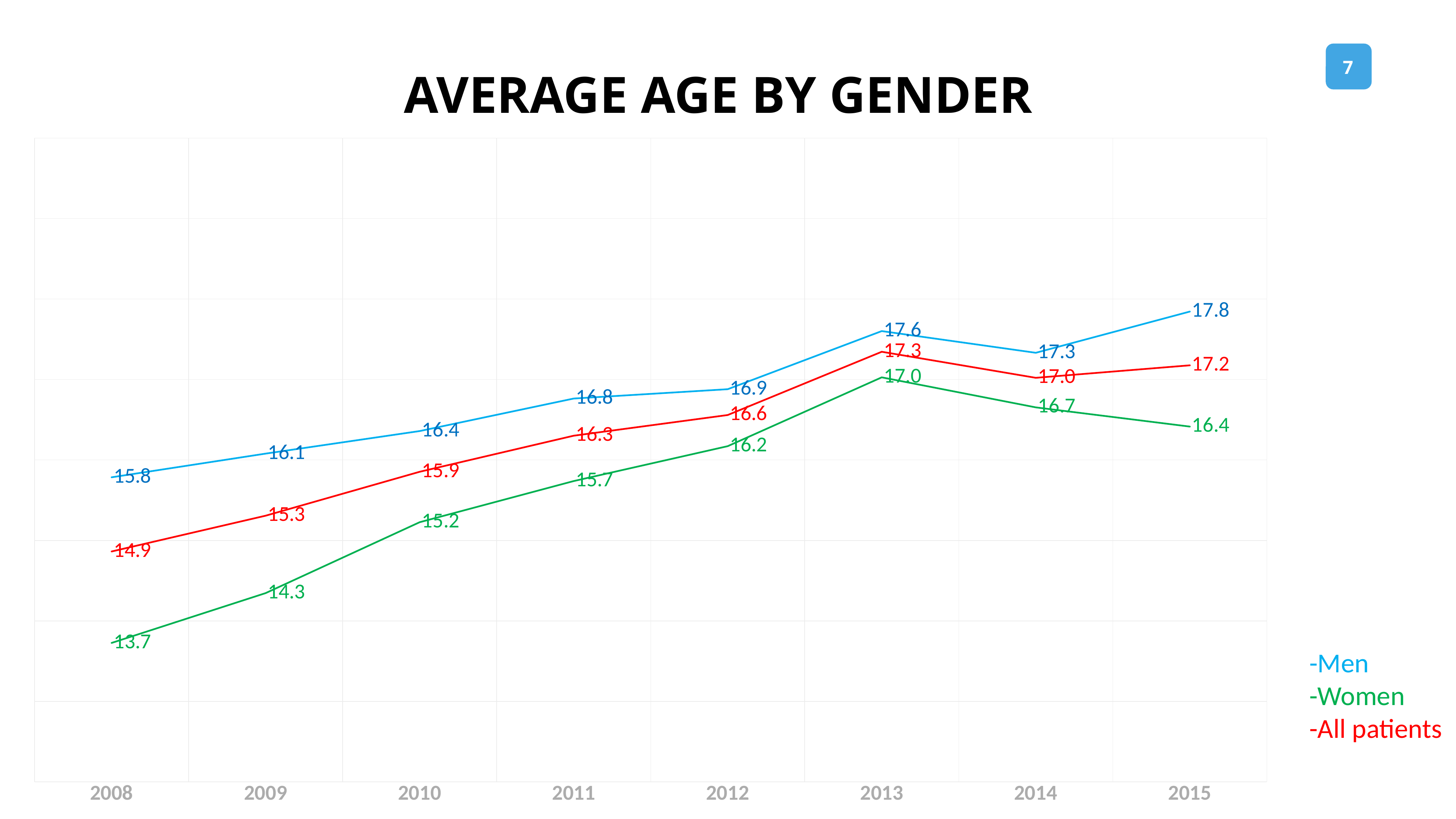
In which year is the average age for Women highest? 2013 In which year is the average age for Men lowest? 2008 What is the average age for Men in 2015? 17.8 What is the average age for All patients in 2013? 17.3 What is the difference between the average age for Men and Women in 2008? 2.1 What type of chart is shown on the slide? Line chart Which is larger in 2015, the average age for Women or for All patients? All patients Which colour represents the All patients series? Red How many years are shown on the x axis? 8 What is the average age for Women in 2008? 13.7 How many series does the legend list? 3 Does the average age for Women rise or fall from 2013 to 2015? Fall